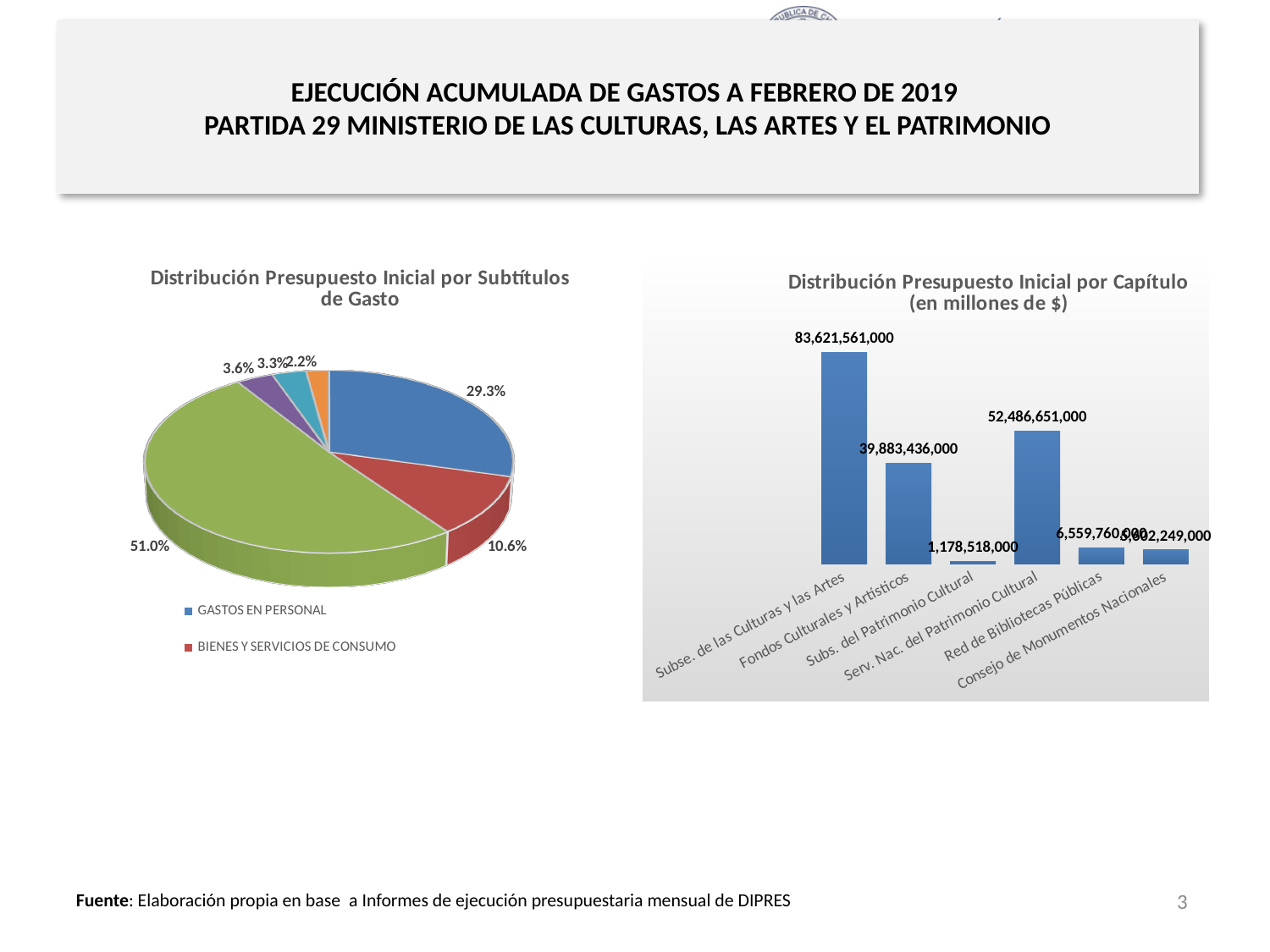
In the chart 'Distribución Presupuesto Inicial por Capítulo', which category has the highest value? Subse. de las Culturas y las Artes What kind of chart is the chart on the left of the slide? Pie chart In the chart 'Distribución Presupuesto Inicial por Capítulo', what is the value for Serv. Nac. del Patrimonio Cultural? 52,486,651,000 In the pie chart 'Distribución Presupuesto Inicial por Subtítulos de Gasto', what share does GASTOS EN PERSONAL have? 29.3% In the chart 'Distribución Presupuesto Inicial por Capítulo', what is the value for Fondos Culturales y Artísticos? 39,883,436,000 In the pie chart on the left, what is the percentage of the largest slice? 51.0% In the chart 'Distribución Presupuesto Inicial por Capítulo', which category has the lowest value? Subs. del Patrimonio Cultural What kind of chart is 'Distribución Presupuesto Inicial por Capítulo'? Bar chart In the chart 'Distribución Presupuesto Inicial por Capítulo', what is the difference between Subse. de las Culturas y las Artes and Serv. Nac. del Patrimonio Cultural? 31,134,910,000 In the pie chart 'Distribución Presupuesto Inicial por Subtítulos de Gasto', what share does BIENES Y SERVICIOS DE CONSUMO have? 10.6% How many slices does the pie chart on the left have? 6 In the pie chart on the left, what is the percentage of the smallest slice? 2.2%